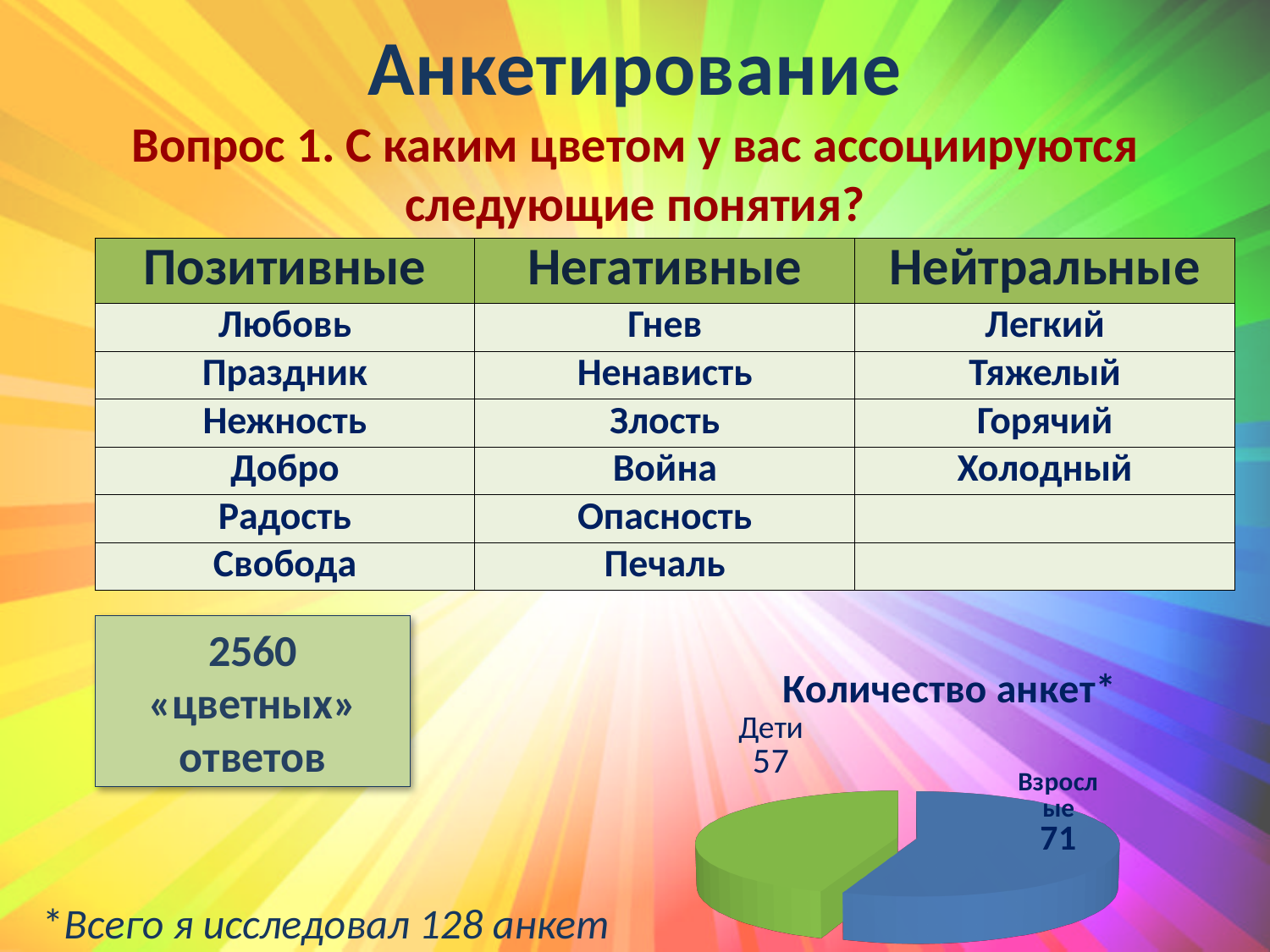
What is the title of the pie chart? Количество анкет* Which category has the smallest slice in the pie chart? Дети Which category has the largest slice in the pie chart? Взрослые What is the total of the two values shown in the pie chart? 128 What colour is the Дети slice in the pie chart? Green What is the difference between the values for Взрослые and Дети in the pie chart? 14 Which is larger in the pie chart, Дети or Взрослые? Взрослые What kind of chart is shown on the slide? Pie chart How many categories does the pie chart show? 2 What is the value for Взрослые in the pie chart? 71 What is the value for Дети in the pie chart? 57